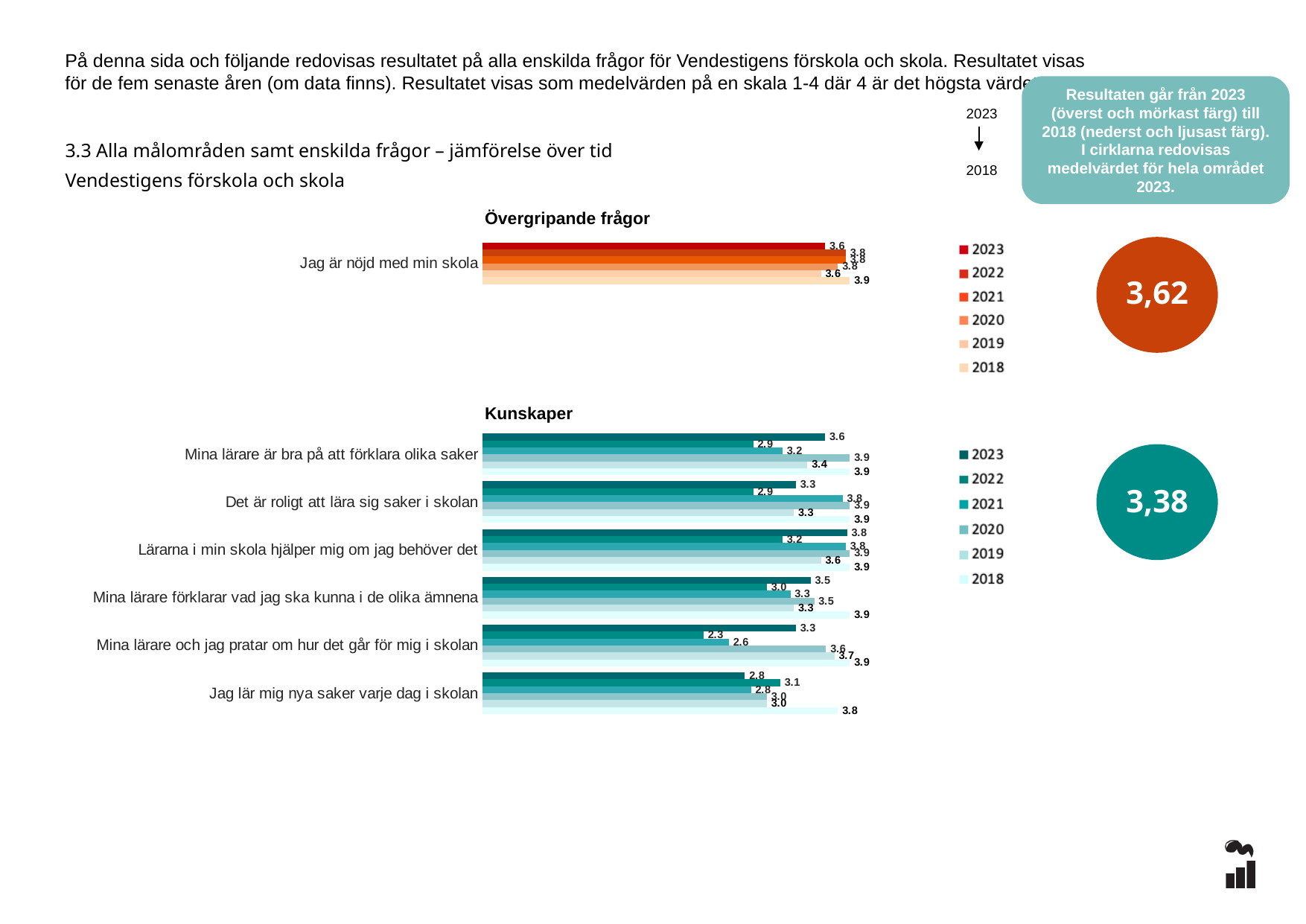
In the Kunskaper chart, what is the 2023 value for "Mina lärare är bra på att förklara olika saker"? 3.6 In the Kunskaper chart, what is the 2023 value for "Mina lärare och jag pratar om hur det går för mig i skolan"? 3.3 In the Övergripande frågor chart, what is the 2023 value for "Jag är nöjd med min skola"? 3.6 How many categories does the Kunskaper chart show? 6 How many series does the legend of the Kunskaper chart list? 6 In the Kunskaper chart, what is the 2018 value for "Jag lär mig nya saker varje dag i skolan"? 3.8 In the Kunskaper chart, which is larger for "Mina lärare är bra på att förklara olika saker": the 2023 value or the 2022 value? 2023 In the Kunskaper chart, what is the difference between the 2023 and 2022 values for "Mina lärare och jag pratar om hur det går för mig i skolan"? 1.0 In the Kunskaper chart, what is the 2022 value for "Mina lärare och jag pratar om hur det går för mig i skolan"? 2.3 In the Kunskaper chart, which category has the highest 2023 value? Lärarna i min skola hjälper mig om jag behöver det In the Kunskaper chart, which category has the lowest 2023 value? Jag lär mig nya saker varje dag i skolan What type of chart is the Kunskaper chart? Bar chart